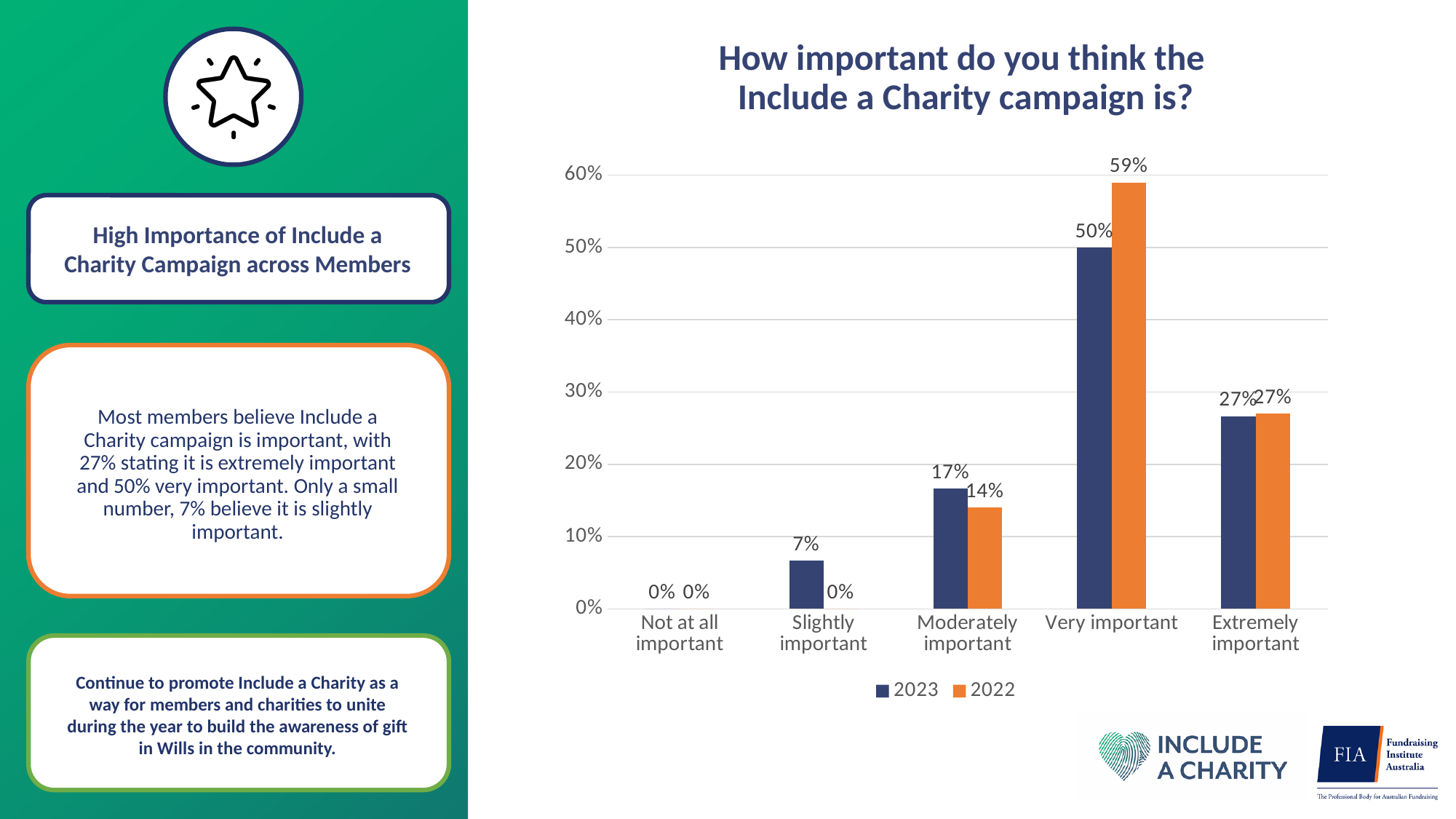
How many series does the legend list? 2 What is the difference between the 2022 and 2023 values for Very important? 9% What is the 2022 value for Slightly important? 0% How many categories are shown on the x axis? 5 Which category has the lowest 2023 value? Not at all important What is the 2023 value for Moderately important? 17% What is the title of the chart? How important do you think the Include a Charity campaign is? Which category has the highest 2022 value? Very important What is the 2023 value for Very important? 50% Which is larger for Moderately important, the 2023 value or the 2022 value? 2023 What is the 2022 value for Very important? 59% What kind of chart is shown? Bar chart